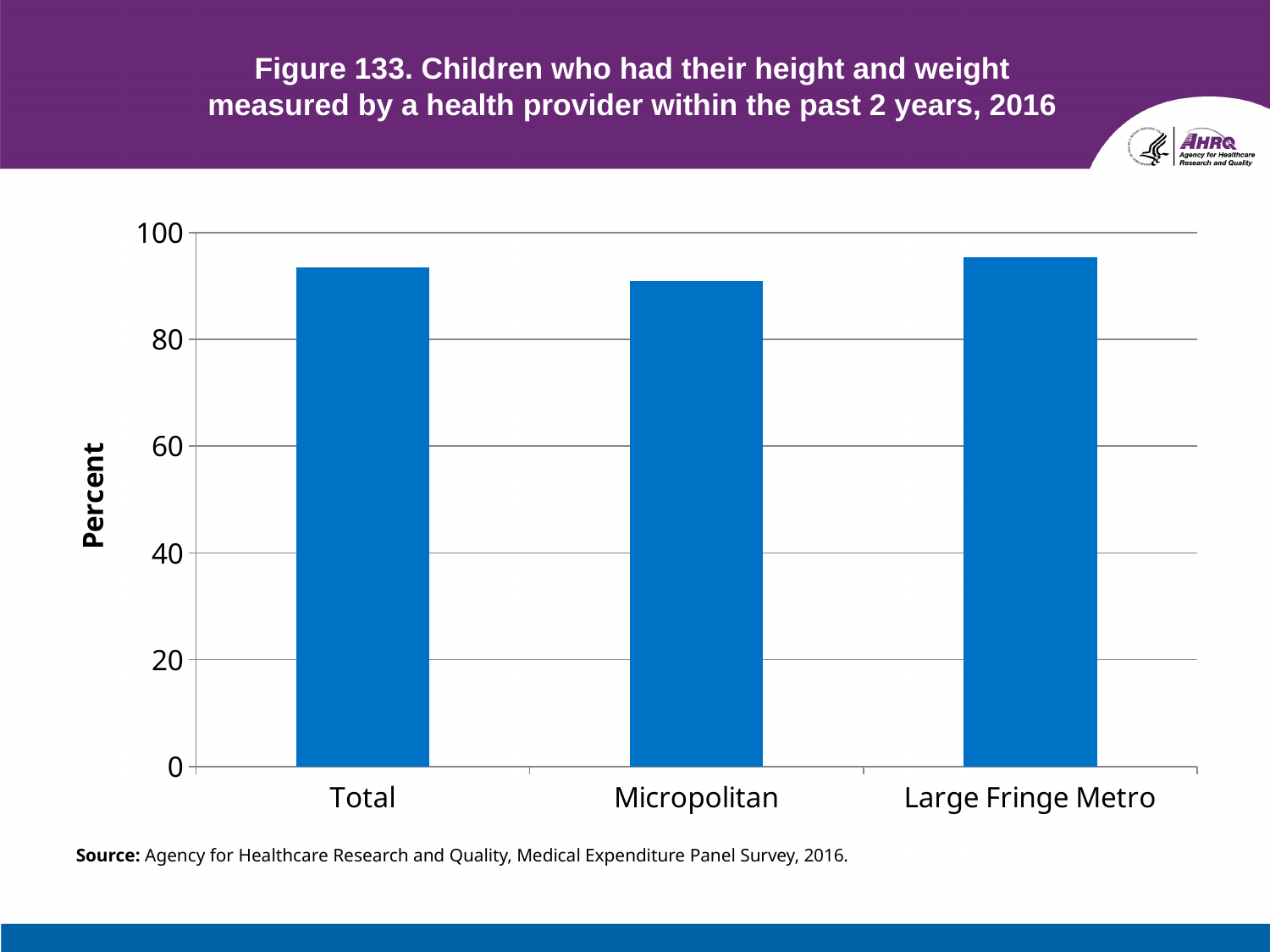
What is the label of the y axis of the chart? Percent Is the value for Large Fringe Metro greater or less than 80? greater Which is larger, the value for Total or the value for Large Fringe Metro? Large Fringe Metro What kind of chart is shown on the slide? Bar chart Which category has the lowest value in the chart? Micropolitan What is the figure number given in the chart title? Figure 133 How many categories are shown on the x axis of the chart? 3 Which is larger, the value for Large Fringe Metro or the value for Micropolitan? Large Fringe Metro Is the value for Micropolitan greater or less than 60? greater Is the value for Micropolitan greater or less than 100? less Which category has the highest value in the chart? Large Fringe Metro